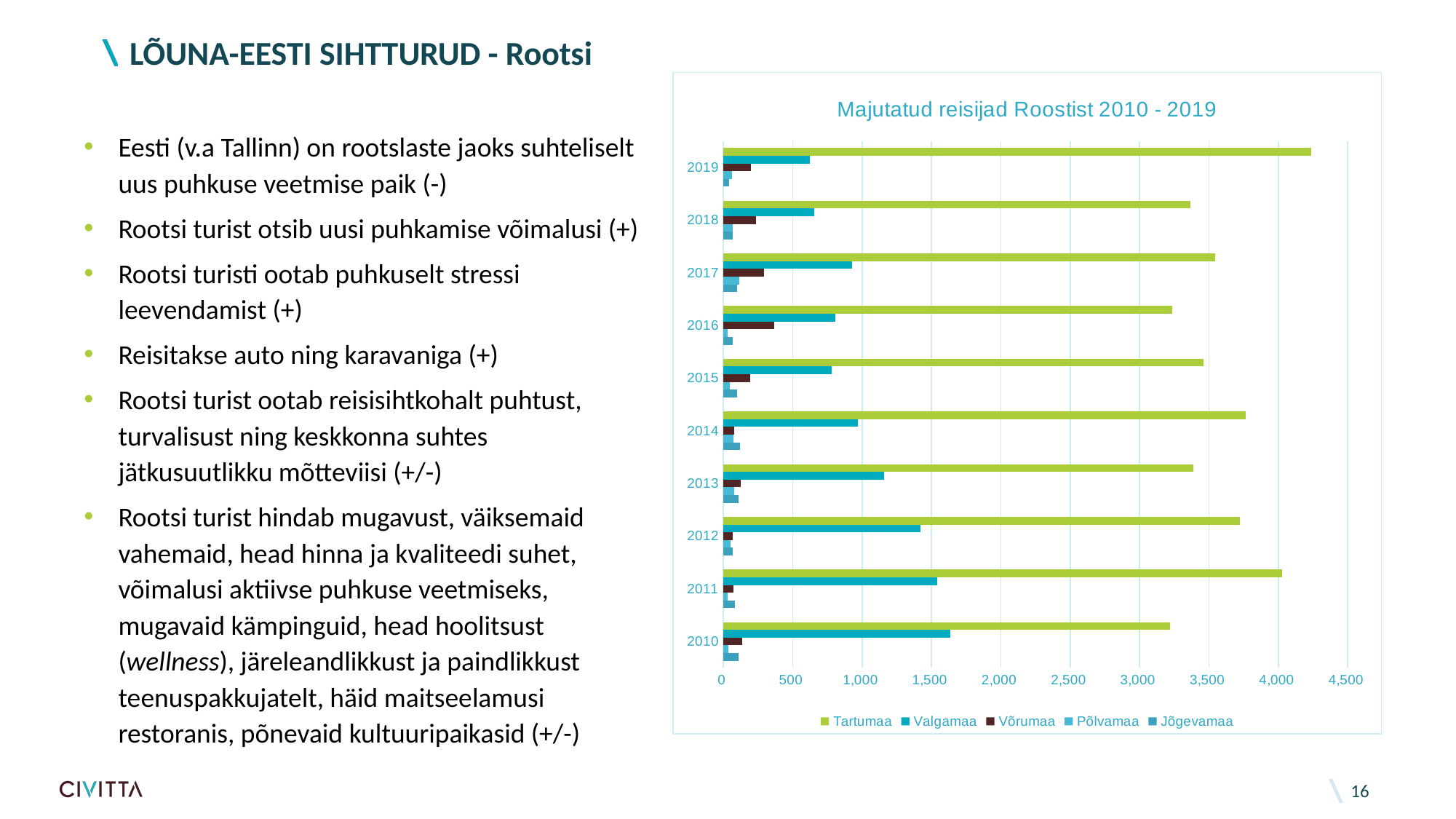
Is the Valgamaa value for 2019 greater or less than 1,000? less Which series has the largest value in every year shown? Tartumaa What is the title of the chart? Majutatud reisijad Roostist 2010 - 2019 How many years are shown on the chart's vertical axis? 10 Is the Tartumaa value for 2019 greater or less than 4,000? greater Which is larger, the Tartumaa value for 2019 or for 2018? 2019 What type of chart is shown on the slide? Bar chart Which is larger, the Valgamaa value for 2011 or for 2019? 2011 Is the Valgamaa value for 2010 greater or less than 1,500? greater How many series does the chart legend list? 5 In which year is the Tartumaa value the highest? 2019